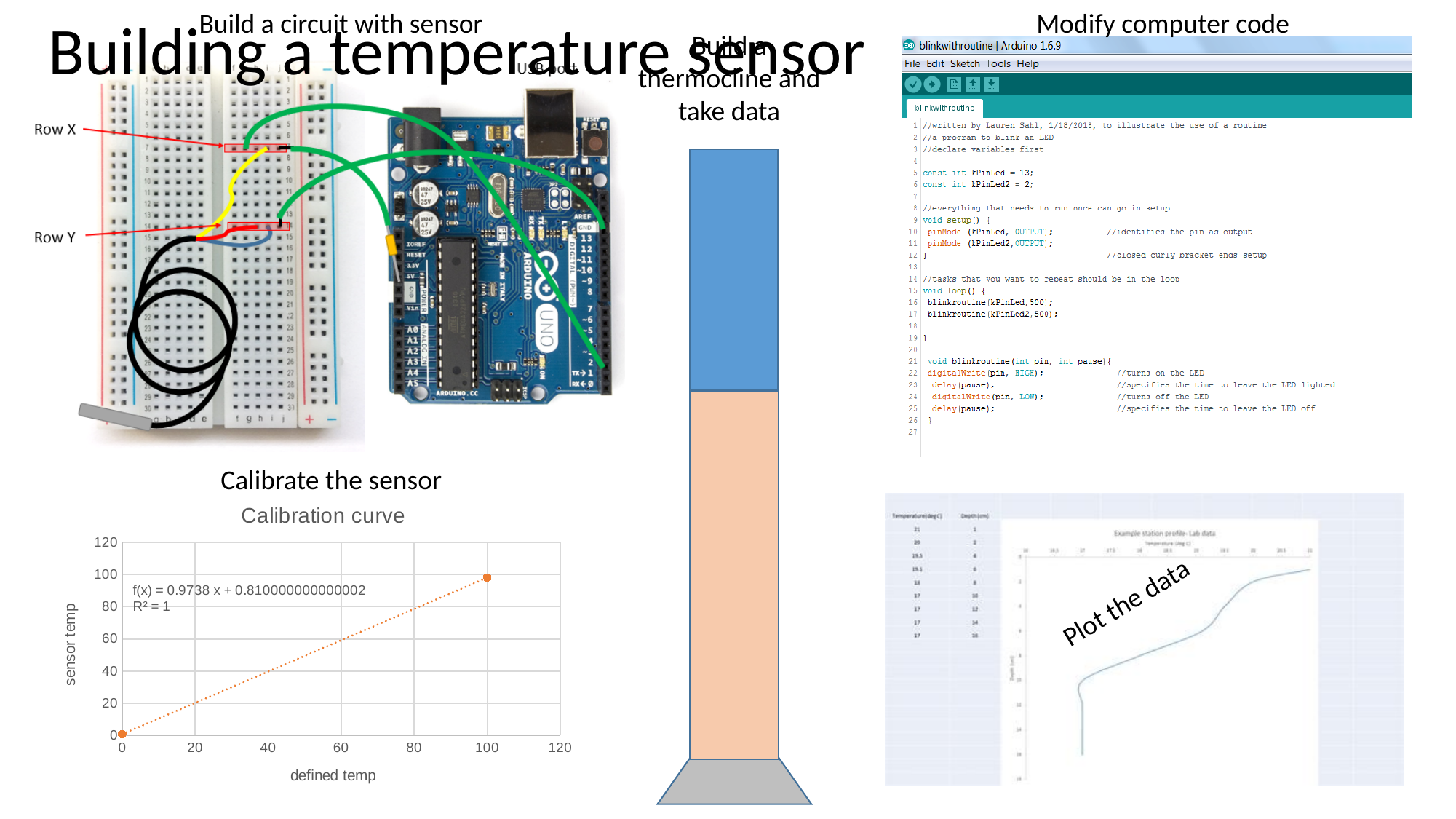
What kind of chart is the Calibration curve chart? scatter chart On the Calibration curve chart, at which defined temp is the sensor temp highest? 100 What is the title of the chart on the lower left of the slide? Calibration curve On the Calibration curve chart, is the sensor temp at a defined temp of 100 greater or less than 80? greater How many data points are plotted on the Calibration curve chart? 2 On the Calibration curve chart, which defined temp has the higher sensor temp, 0 or 100? 100 On the Calibration curve chart, at which defined temp is the sensor temp lowest? 0 On the Calibration curve chart, is the sensor temp at a defined temp of 0 greater or less than 20? less On the Calibration curve chart, does sensor temp rise or fall as defined temp increases? rise What trendline equation is shown on the Calibration curve chart? f(x) = 0.9738 x + 0.810000000000002